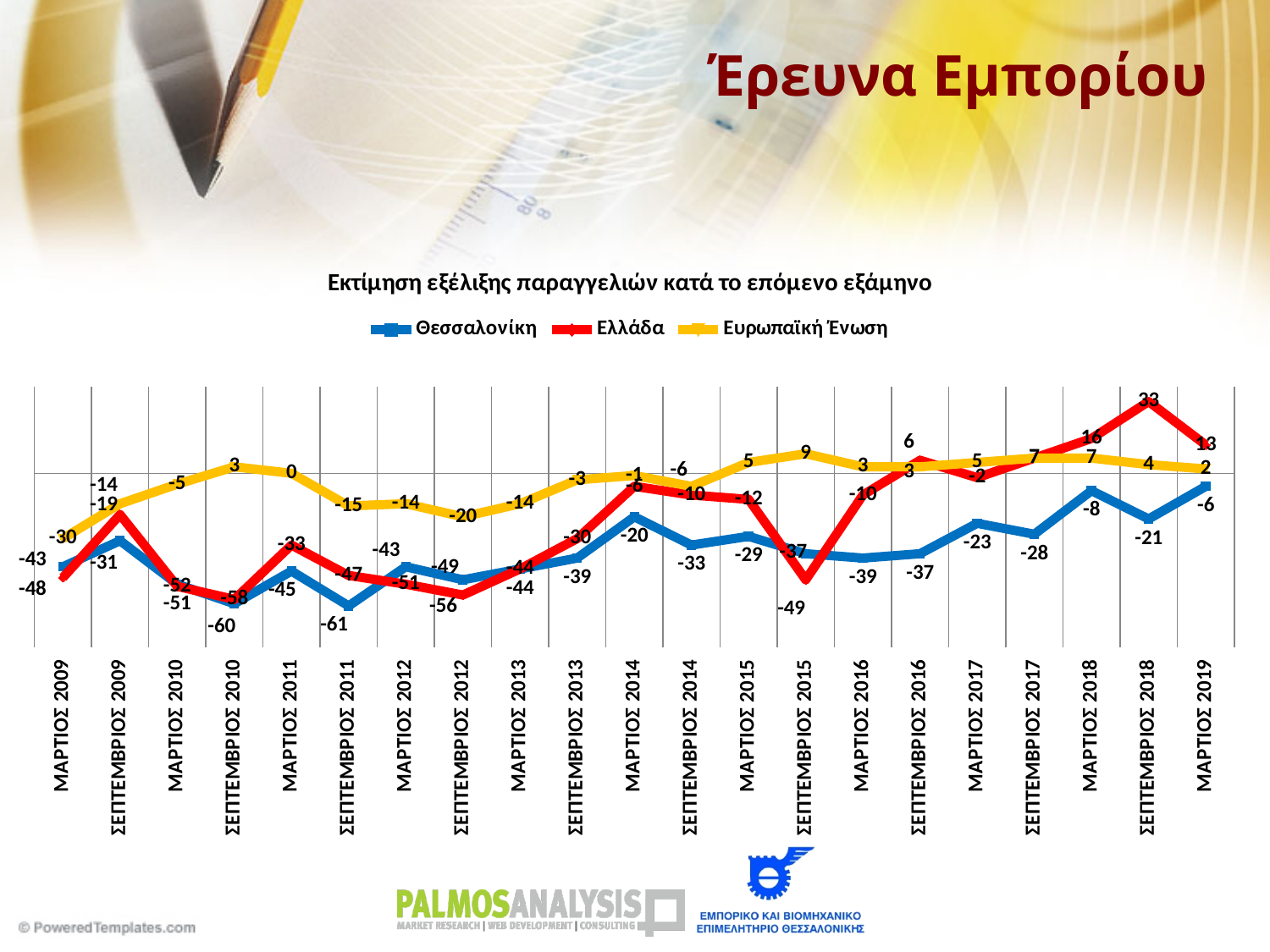
In which period does the Θεσσαλονίκη series reach its lowest value? ΣΕΠΤΕΜΒΡΙΟΣ 2011 What is the value for Ελλάδα in ΣΕΠΤΕΜΒΡΙΟΣ 2018? 33 What is the value for Θεσσαλονίκη in ΜΑΡΤΙΟΣ 2019? -6 How many series does the legend list? 3 By how much did the Ελλάδα value fall from ΣΕΠΤΕΜΒΡΙΟΣ 2018 to ΜΑΡΤΙΟΣ 2019? 20 What is the title of the chart? Εκτίμηση εξέλιξης παραγγελιών κατά το επόμενο εξάμηνο What type of chart is shown on the slide? line chart How many time points are shown on the x axis? 21 In ΣΕΠΤΕΜΒΡΙΟΣ 2015, which series has the higher value, Θεσσαλονίκη or Ελλάδα? Θεσσαλονίκη What is the value for Θεσσαλονίκη in ΜΑΡΤΙΟΣ 2018? -8 In which period does the Ελλάδα series reach its highest value? ΣΕΠΤΕΜΒΡΙΟΣ 2018 What is the value for Ευρωπαϊκή Ένωση in ΣΕΠΤΕΜΒΡΙΟΣ 2015? 9